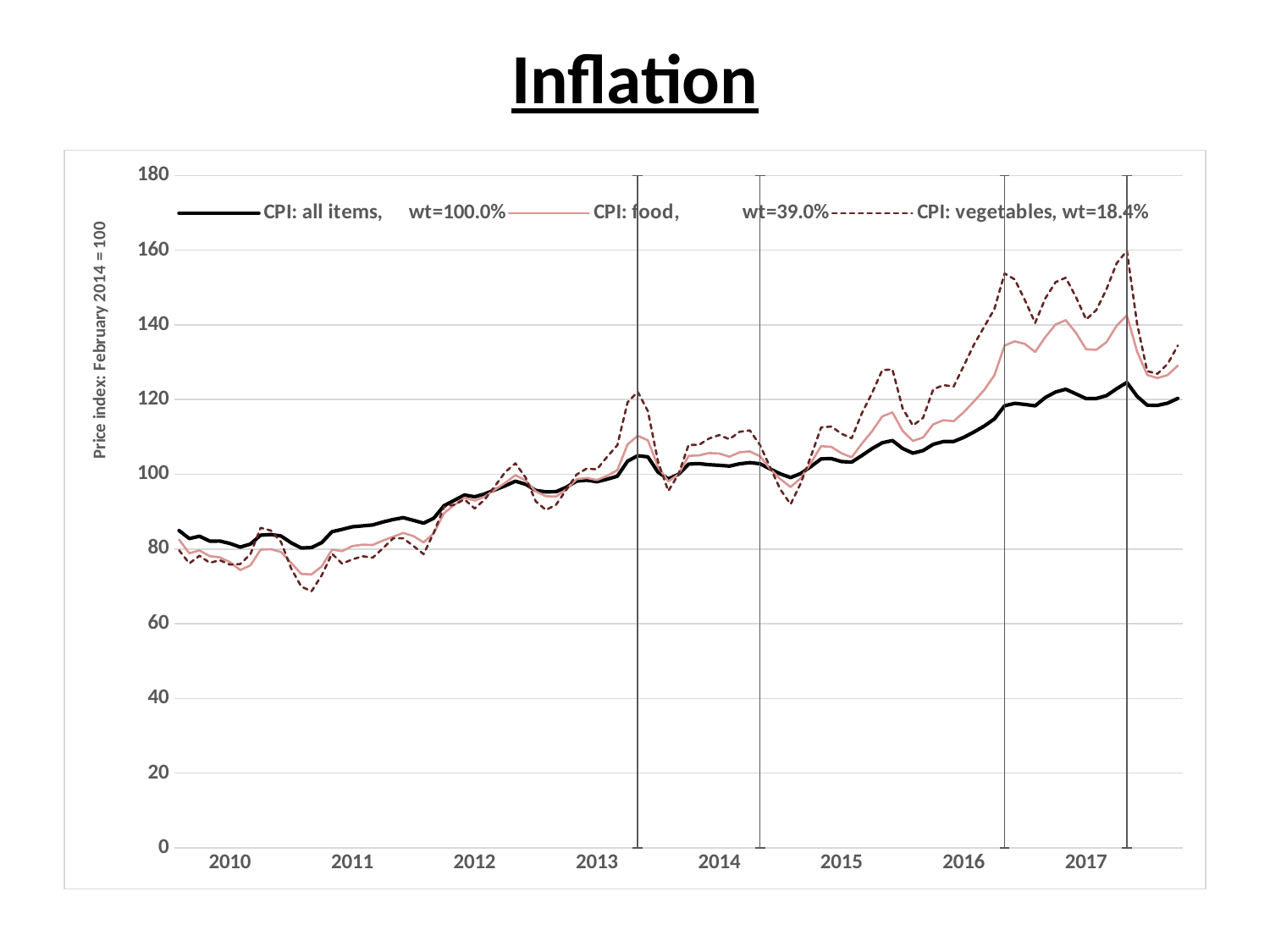
Which series has the lowest value on the chart, around late 2010? CPI: vegetables Which series reaches the highest value on the chart? CPI: vegetables What is the label on the vertical axis? Price index: February 2014 = 100 In 2017, which is larger: CPI: food or CPI: all items? CPI: food What is the title of the slide? Inflation Is the peak value of CPI: vegetables in 2017 greater or less than 140? greater What weight is shown for CPI: food in the legend? wt=39.0% How many series does the legend list? 3 Does the CPI: all items series generally rise or fall from 2010 to 2017? rise Is the value of CPI: all items at the start of 2010 greater or less than 100? less Is the value of CPI: all items at the end of 2017 greater or less than 100? greater What kind of chart is shown on the slide? line chart